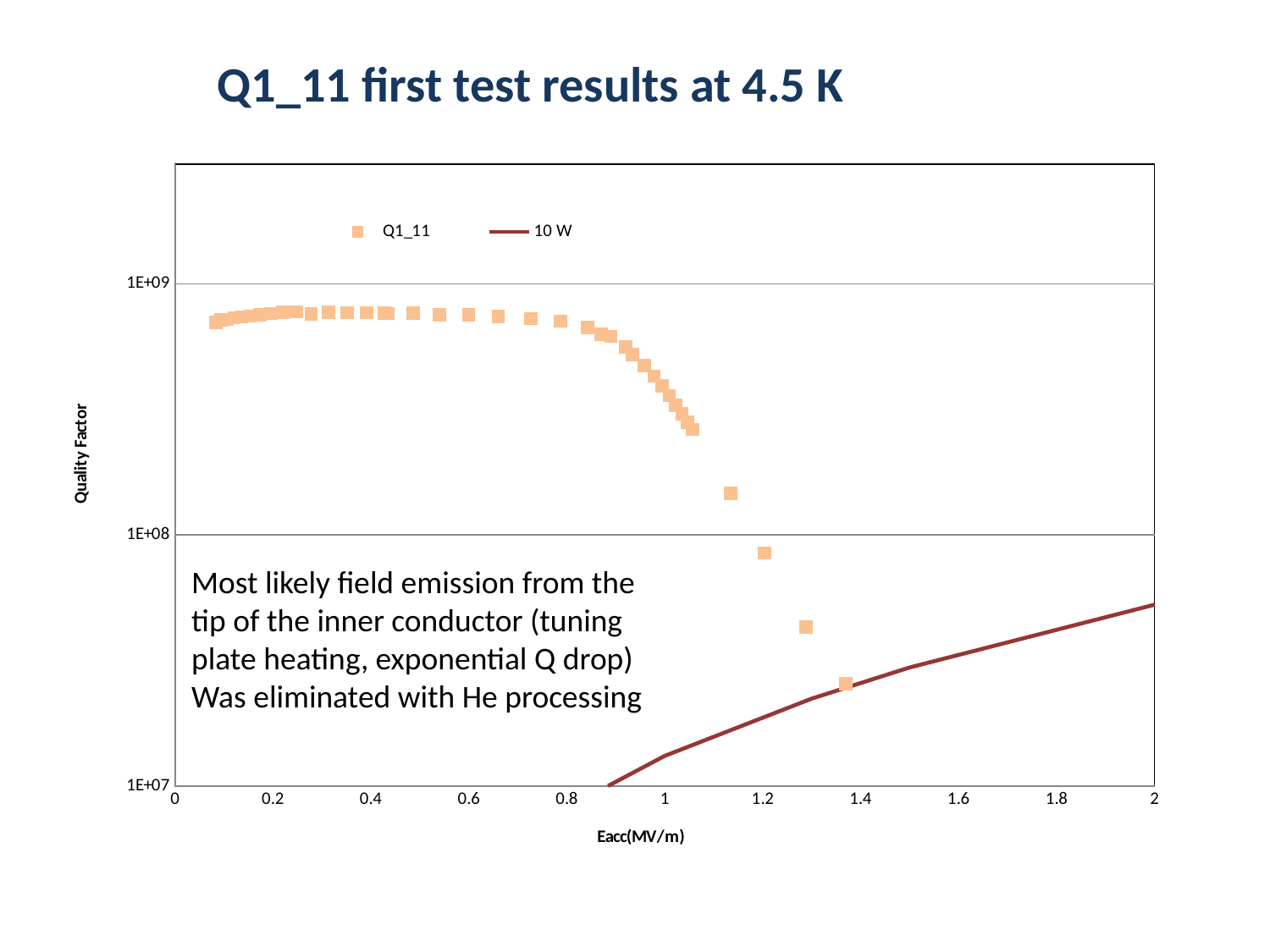
Is the Q1_11 quality factor at Eacc of about 0.2 MV/m greater or less than 1E+08? greater Is the Q1_11 quality factor at Eacc of about 0.2 MV/m greater or less than 1E+09? less Is the 10 W line value at Eacc of 2 MV/m greater or less than 1E+08? less At Eacc of about 1.2 MV/m, which is larger: the Q1_11 quality factor or the 10 W line? Q1_11 Does the 10 W line rise or fall as Eacc increases along the x axis? rise Do the Q1_11 values rise or fall as Eacc increases along the x axis? fall What are the two series named in the chart legend? Q1_11 and 10 W What kind of chart is shown on the slide? scatter chart What is the label of the chart's x axis? Eacc(MV/m) How many series does the chart legend list? 2